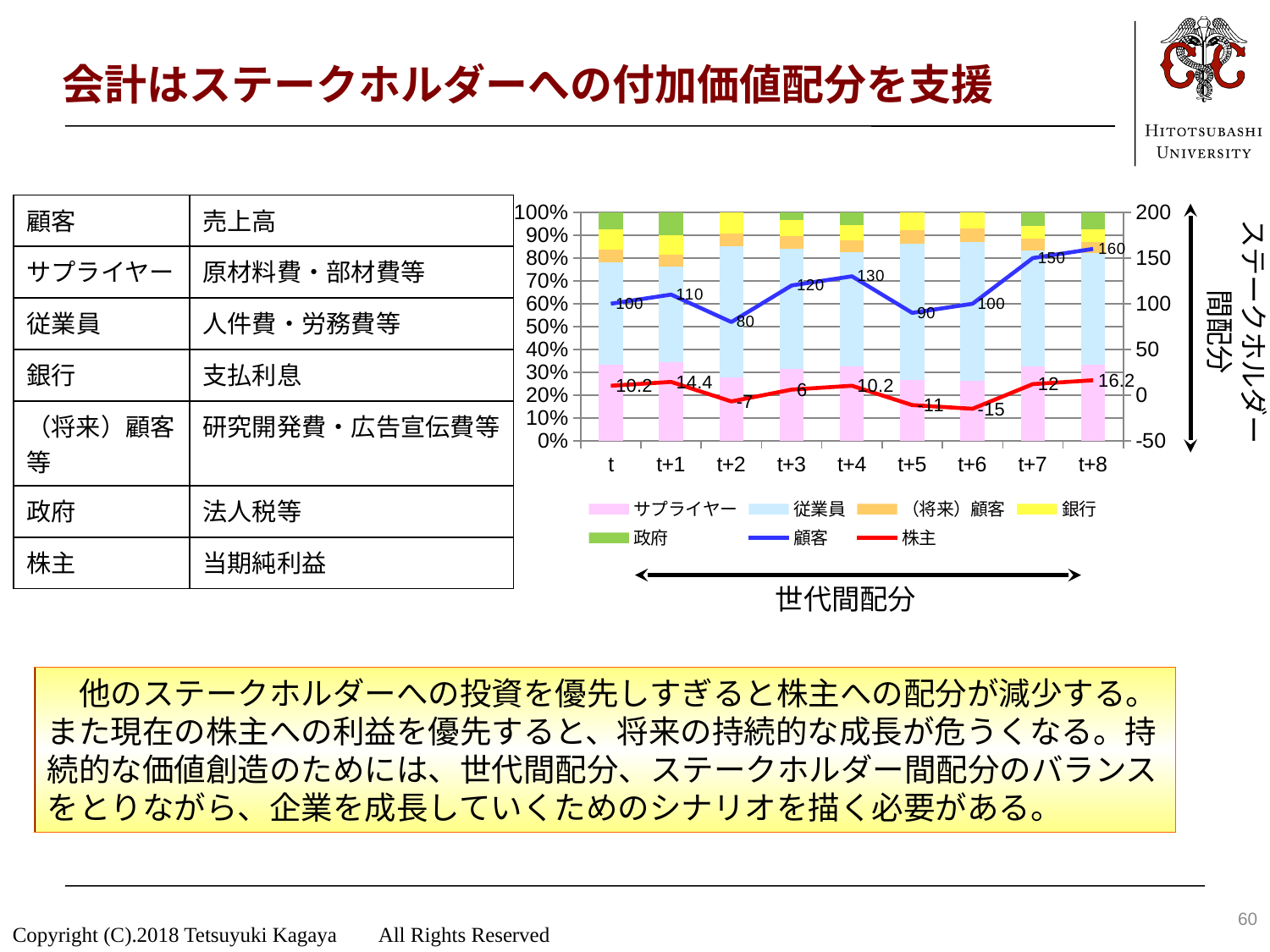
Does the 顧客 line rise or fall from t+5 to t+8? Rises How many series does the chart legend list? 7 How many periods are shown on the x axis of the chart? 9 At which period does the 株主 line reach its lowest value? t+6 What colour is the 株主 line in the chart? Red What is the value of the 顧客 line at t+4? 130 What kind of chart is shown on the slide? Combination of a stacked bar chart and line chart What is the value of the 株主 line at t+6? -15 What is the value of the 株主 line at t+1? 14.4 What is the difference between the 顧客 value at t+8 and at t? 60 Which is larger for the 顧客 line: the value at t+3 or at t+5? t+3 At which period does the 顧客 line reach its highest value? t+8